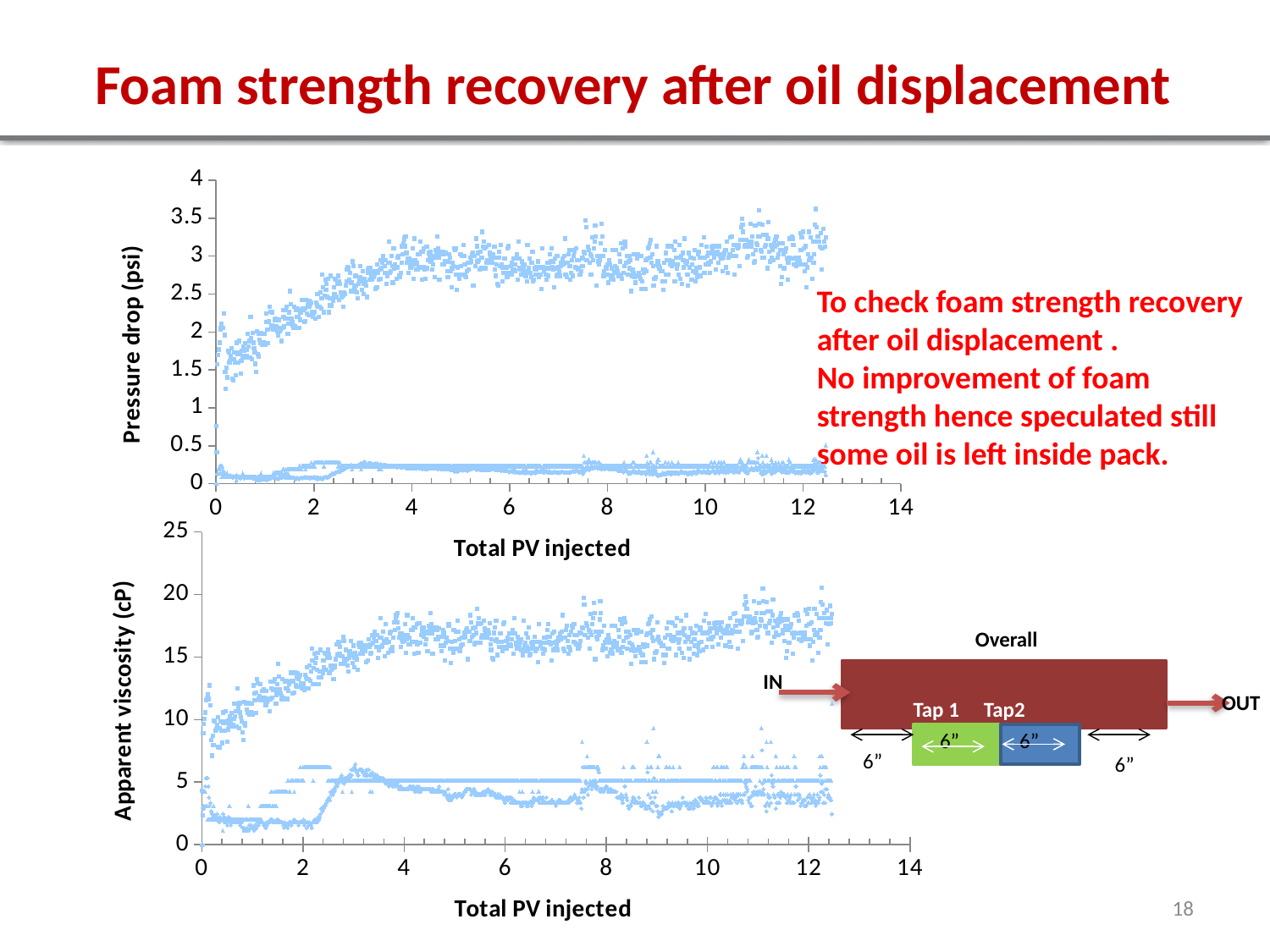
How many labelled tick marks are on the x-axis of the bottom chart? 8 What type of chart is the top chart on the slide? Scatter chart In the bottom chart (Apparent viscosity), is the value of the upper series at 10 total PV injected greater or less than 10? greater What type of chart is the bottom chart on the slide? Scatter chart In the top chart (Pressure drop), is the value of the lower series at 8 total PV injected greater or less than 1? less What is the y-axis label of the bottom chart? Apparent viscosity (cP) In the bottom chart (Apparent viscosity), is the value of the lower series at 1 total PV injected greater or less than 5? less In the bottom chart (Apparent viscosity), does the upper series rise or fall between 0 and 4 total PV injected? Rise In the top chart (Pressure drop), does the upper series rise or fall between 0 and 4 total PV injected? Rise What is the highest value shown on the y-axis of the top chart? 4 What is the y-axis label of the top chart? Pressure drop (psi)